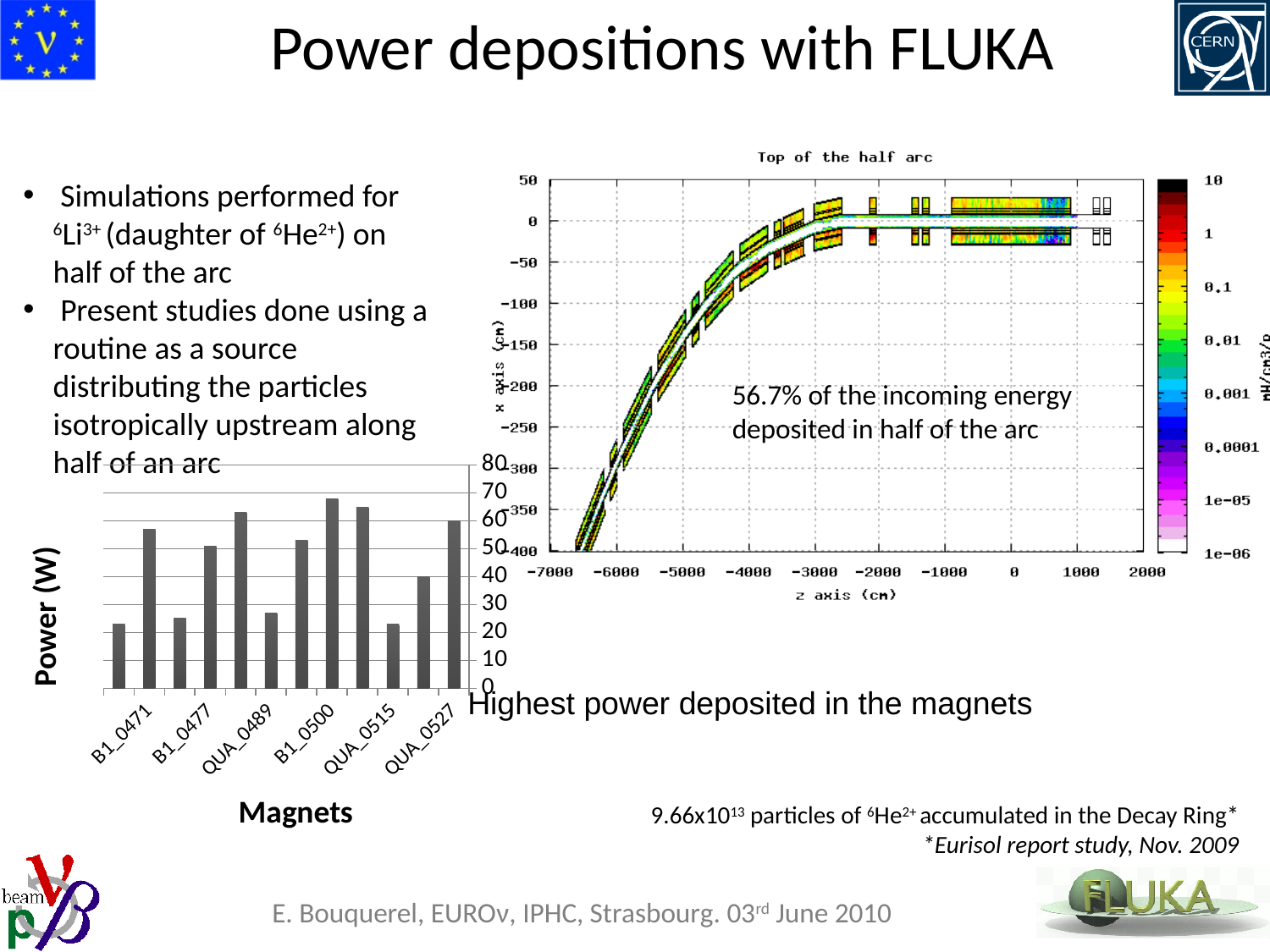
In the bar chart with the y axis labelled 'Power (W)', is the value for QUA_0527 greater or less than 50? greater In the bar chart with the y axis labelled 'Power (W)', what is the x axis title? Magnets What is the title of the colour-map plot on the right of the slide? Top of the half arc In the bar chart with the y axis labelled 'Power (W)', how many bars are plotted? 12 In the bar chart with the y axis labelled 'Power (W)', is the value for B1_0500 greater or less than 50? greater In the bar chart with the y axis labelled 'Power (W)', is the value for B1_0477 greater or less than 30? greater What kind of chart is the chart with the y axis labelled 'Power (W)'? bar chart In the bar chart with the y axis labelled 'Power (W)', which has the larger value, QUA_0489 or B1_0471? B1_0471 In the bar chart with the y axis labelled 'Power (W)', which has the larger value, B1_0500 or QUA_0527? B1_0500